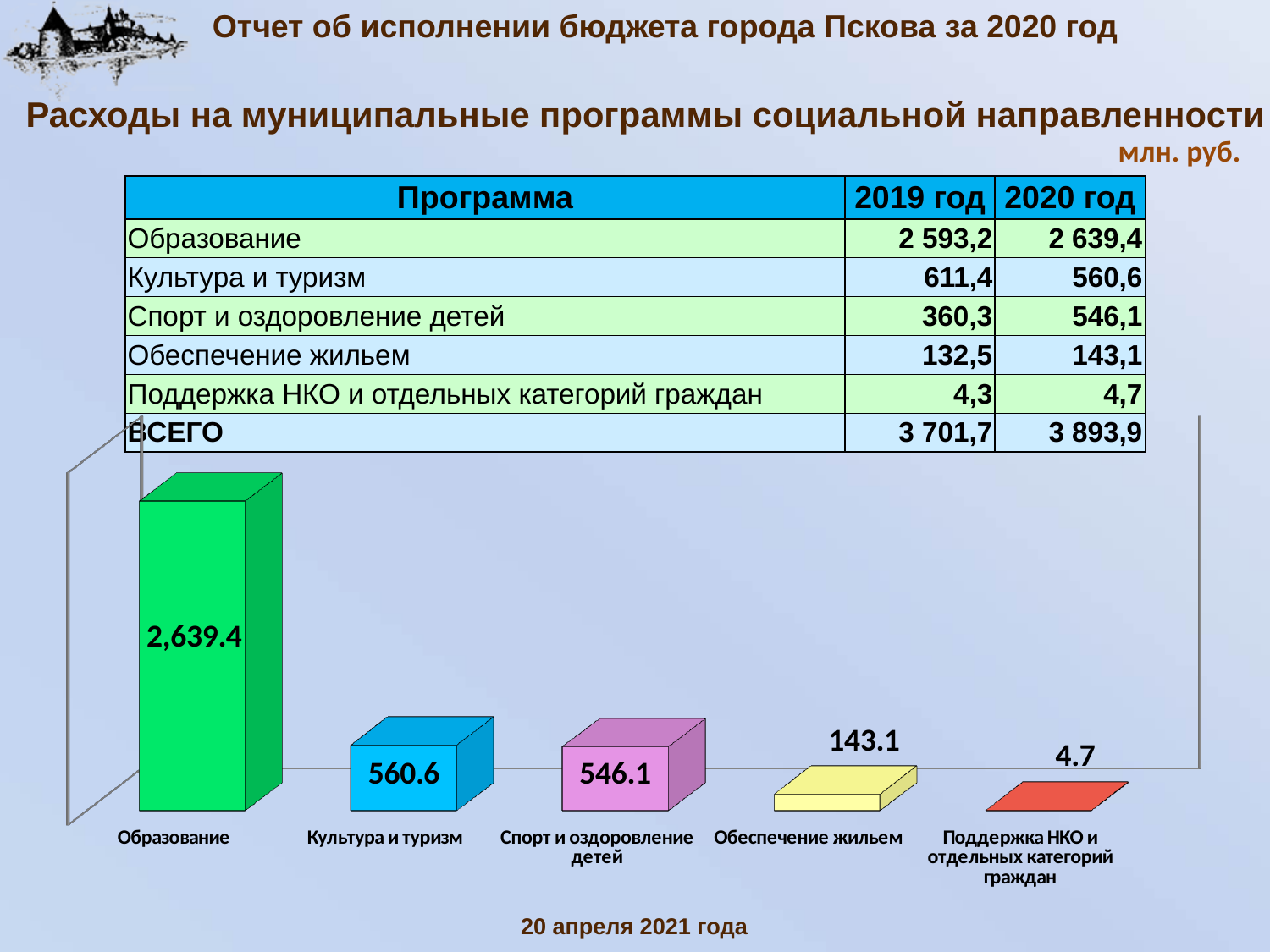
What is the value shown for Поддержка НКО и отдельных категорий граждан in the bar chart? 4.7 Which category has the lowest value in the bar chart? Поддержка НКО и отдельных категорий граждан What is the value shown for Культура и туризм in the bar chart? 560.6 What is the difference between the values for Обеспечение жильем and Поддержка НКО и отдельных категорий граждан in the bar chart? 138.4 What is the value shown for Образование in the bar chart? 2,639.4 What is the value shown for Обеспечение жильем in the bar chart? 143.1 What is the difference between the values for Культура и туризм and Спорт и оздоровление детей in the bar chart? 14.5 What is the value shown for Спорт и оздоровление детей in the bar chart? 546.1 How many categories are plotted in the bar chart? 5 In the bar chart, which is larger: the value for Культура и туризм or the value for Спорт и оздоровление детей? Культура и туризм Which category has the highest value in the bar chart? Образование What type of chart is shown on the slide? Bar chart